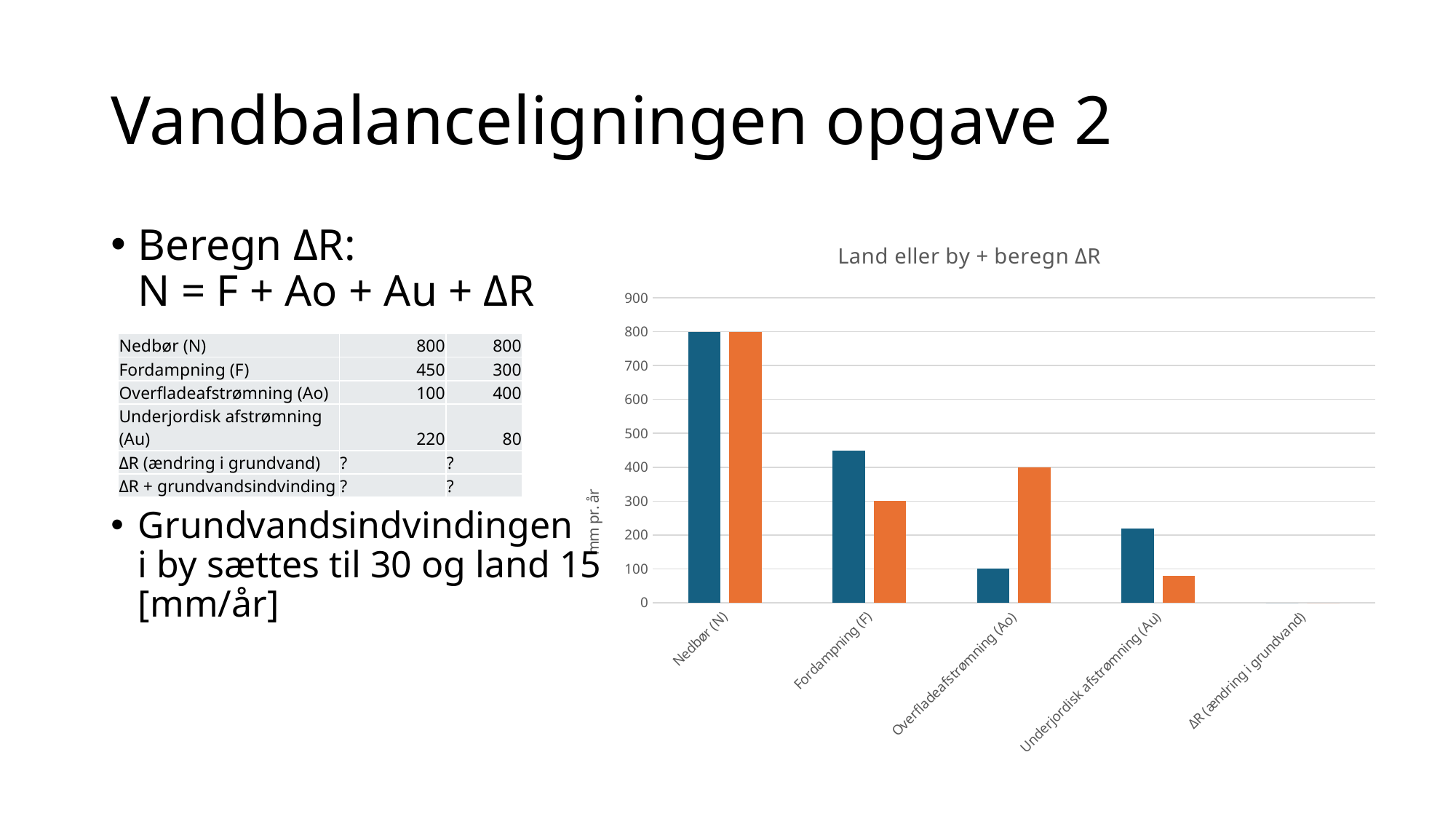
What type of chart is shown on the slide? bar chart What is the value of the blue bar for Overfladeafstrømning (Ao)? 100 Is the orange bar for Underjordisk afstrømning (Au) greater or less than 100? less What is the value of the blue bar for Nedbør (N)? 800 What is the value of the orange bar for Fordampning (F)? 300 For Overfladeafstrømning (Ao), is the blue bar or the orange bar larger? orange What is the value of the orange bar for Overfladeafstrømning (Ao)? 400 Which category has the lowest orange bar among those with visible bars? Underjordisk afstrømning (Au) What is the title of the chart? Land eller by + beregn ΔR How many categories are shown on the x axis of the chart? 5 Is the blue bar for Fordampning (F) greater or less than 400? greater Which category has the highest blue bar? Nedbør (N)